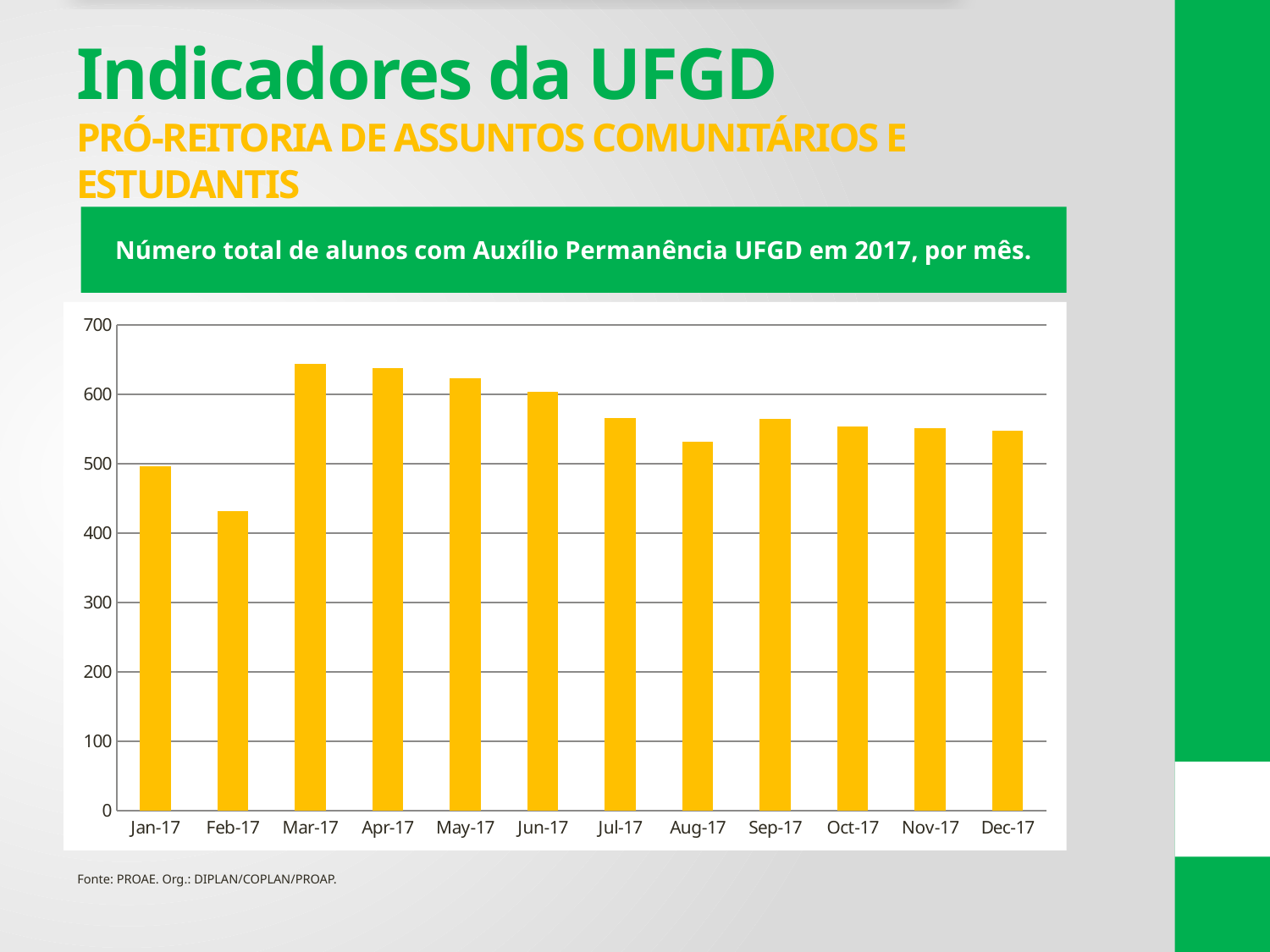
What kind of chart is shown on the slide? bar chart Is the value for Mar-17 greater or less than 600? greater How many months are plotted on the x axis of the chart? 12 What is the title of the chart? Número total de alunos com Auxílio Permanência UFGD em 2017, por mês. Is the value for Aug-17 greater or less than 500? greater Is the value for Dec-17 greater or less than 500? greater Do the values rise or fall from Mar-17 to Jun-17? fall Which is larger, the value for Jan-17 or the value for Feb-17? Jan-17 Which month has the lowest number of students with Auxílio Permanência? Feb-17 Which is larger, the value for Jul-17 or the value for Aug-17? Jul-17